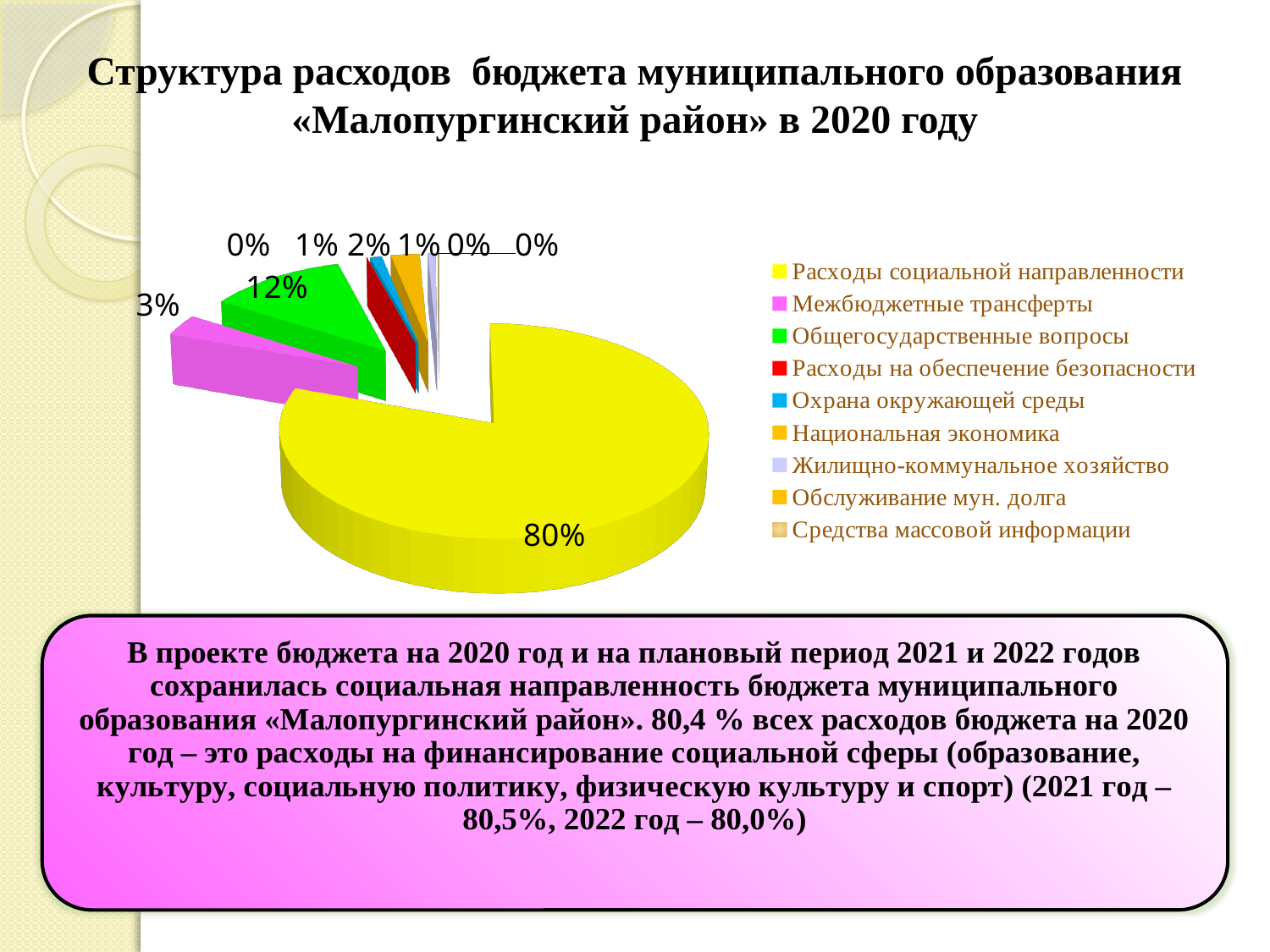
How many categories does the legend of the pie chart list? 9 What percentage is shown for «Общегосударственные вопросы»? 12% By how many percentage points does «Расходы социальной направленности» exceed «Общегосударственные вопросы»? 68 percentage points What share of the pie is labelled for «Расходы социальной направленности»? 80% Which category has the largest slice of the pie? Расходы социальной направленности What kind of chart is shown on the slide? pie chart Which is larger: «Общегосударственные вопросы» or «Межбюджетные трансферты»? Общегосударственные вопросы Which year does the chart title say the budget expenditure structure refers to? 2020 What colour is the largest slice of the pie chart? yellow What is the difference between the shares of «Общегосударственные вопросы» and «Межбюджетные трансферты»? 9 percentage points What percentage is shown for «Межбюджетные трансферты»? 3%